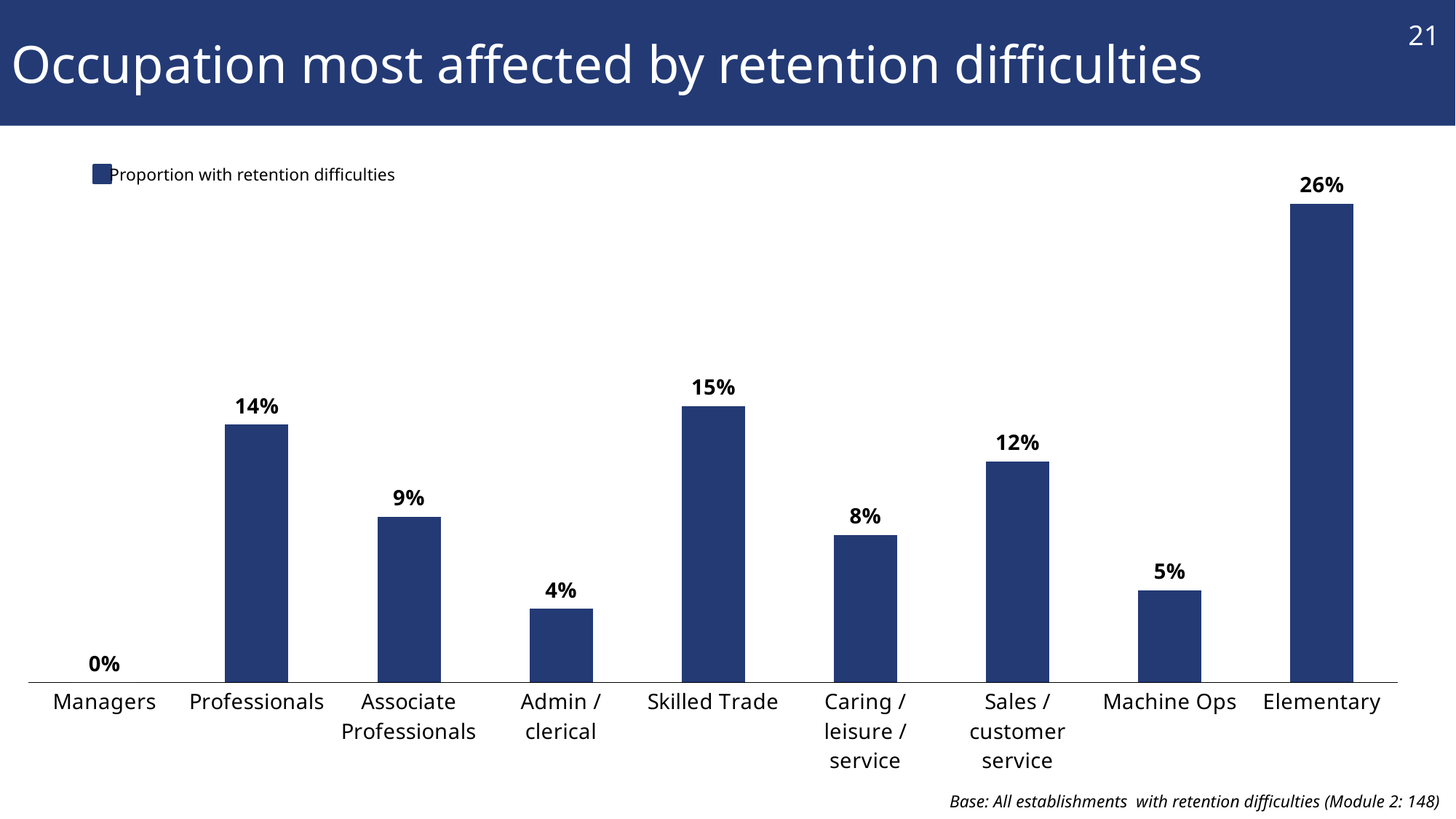
Which occupation has the highest proportion with retention difficulties? Elementary Which has a higher proportion with retention difficulties, Professionals or Associate Professionals? Professionals Which occupation has the lowest proportion with retention difficulties? Managers What kind of chart is shown on the slide? Bar chart What is the proportion with retention difficulties for Skilled Trade? 15% What is the proportion with retention difficulties for Caring / leisure / service? 8% What is the proportion with retention difficulties for Machine Ops? 5% What is the legend entry for the series shown on the chart? Proportion with retention difficulties What is the difference between the proportion for Sales / customer service and the proportion for Admin / clerical? 8% What is the difference between the proportion for Elementary and the proportion for Professionals? 12% Which has a higher proportion with retention difficulties, Caring / leisure / service or Sales / customer service? Sales / customer service How many occupation categories are shown on the chart? 9